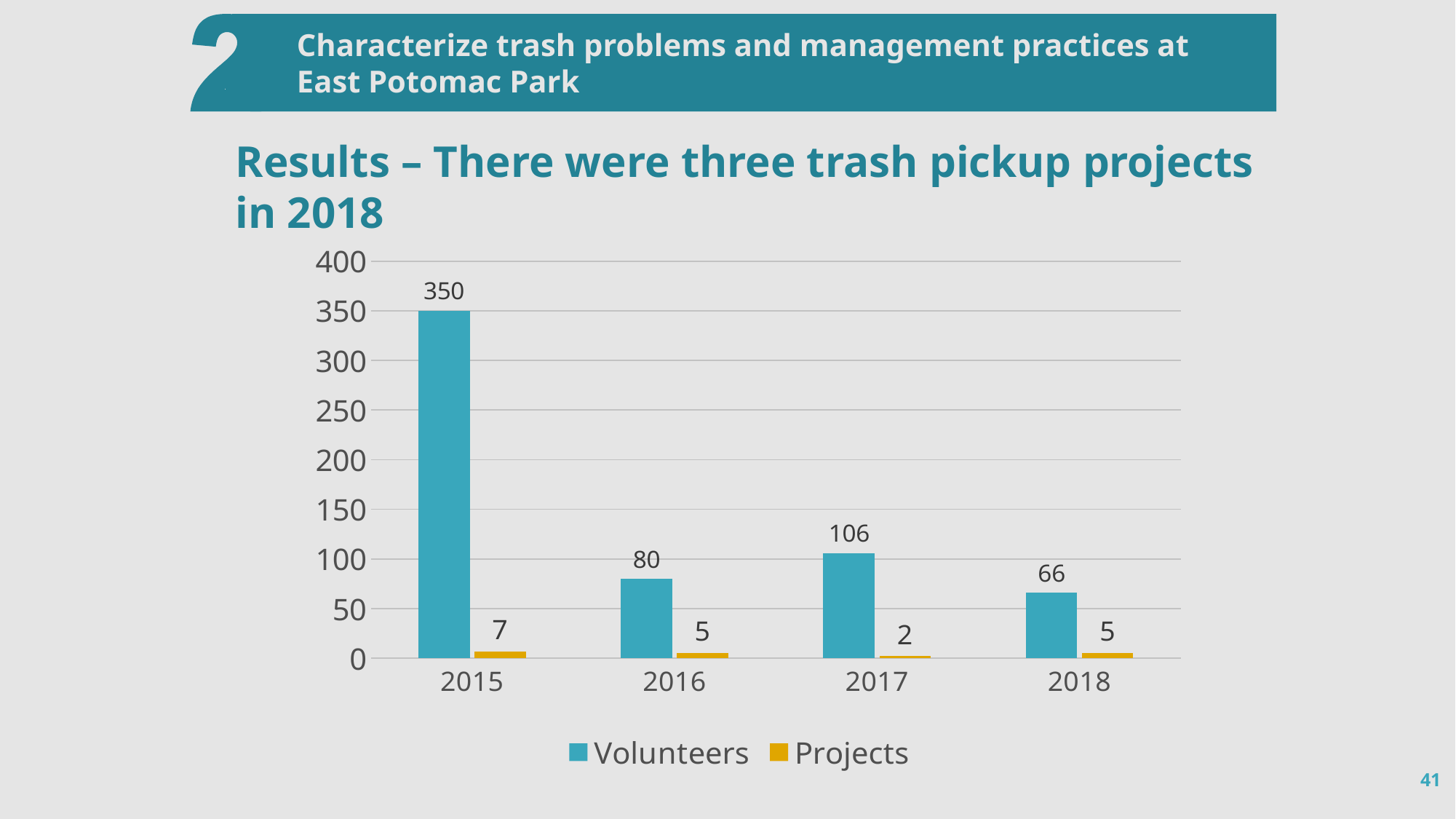
What colour are the Projects bars? yellow Which year had the lowest number of projects? 2017 What is the value for Volunteers in 2018? 66 Which year had more volunteers, 2017 or 2018? 2017 How many projects were there in 2017? 2 Which year had the highest number of volunteers? 2015 How many volunteers were there in 2015? 350 What is the difference in volunteers between 2015 and 2016? 270 How many series does the legend list? 2 How many years are shown on the x axis? 4 Is the value for Volunteers in 2017 greater or less than 150? less What kind of chart is shown on the slide? bar chart